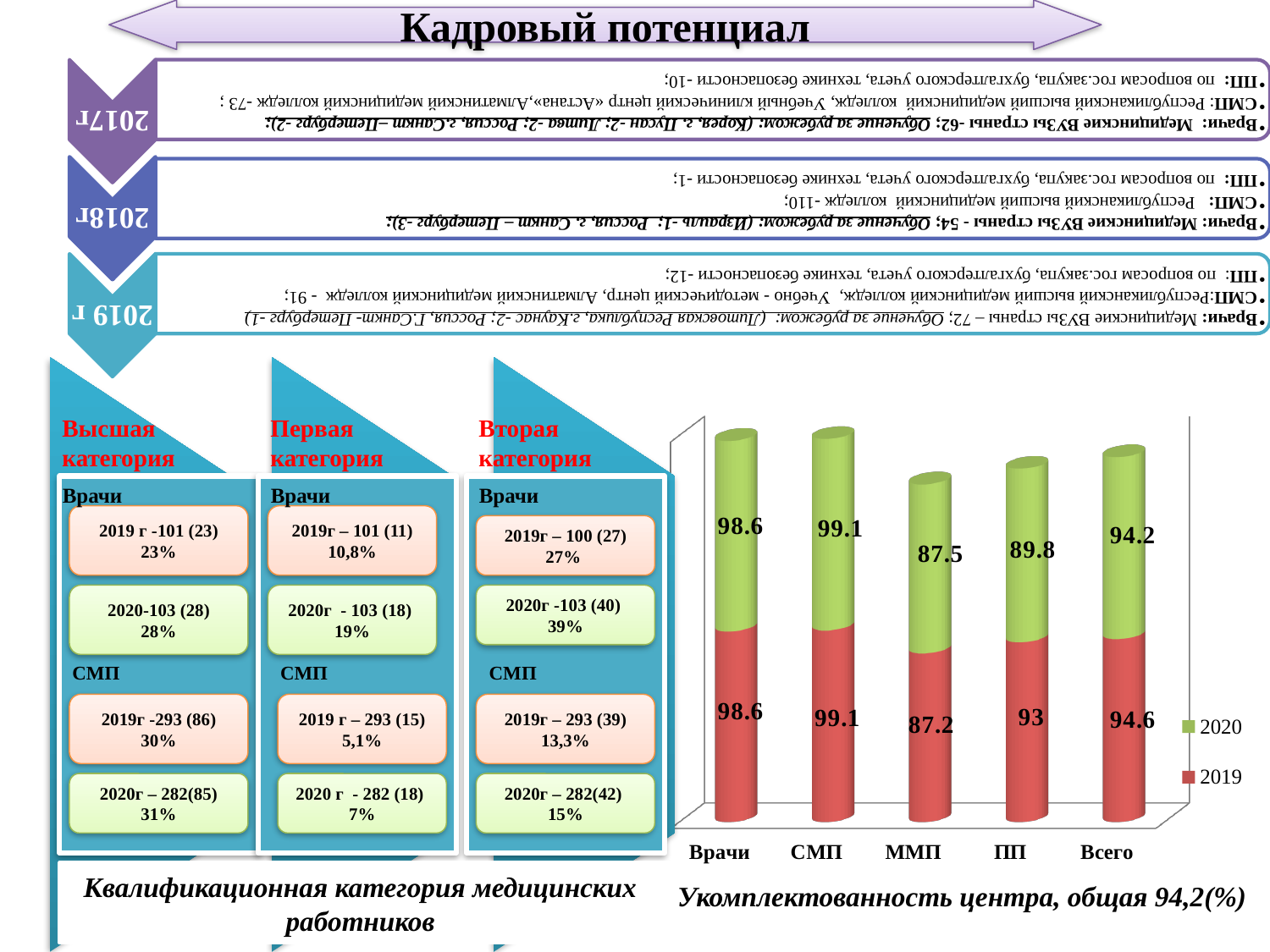
Which category has the highest 2020 value in the chart? СМП Which category has the lowest 2019 value in the chart? ММП What is the 2020 value for Врачи in the chart? 98.6 How many series does the chart legend list? 2 What is the 2020 value for ПП in the chart? 89.8 How many categories are shown on the x axis of the chart? 5 What is the 2019 value for Всего in the chart? 94.6 What kind of chart is shown on the slide? Stacked bar chart For Всего, which is larger: the 2019 value or the 2020 value? 2019 What is the difference between the 2019 and 2020 values for ПП? 3.2 Which colour represents the 2019 series in the chart? Red What is the 2019 value for ММП in the chart? 87.2